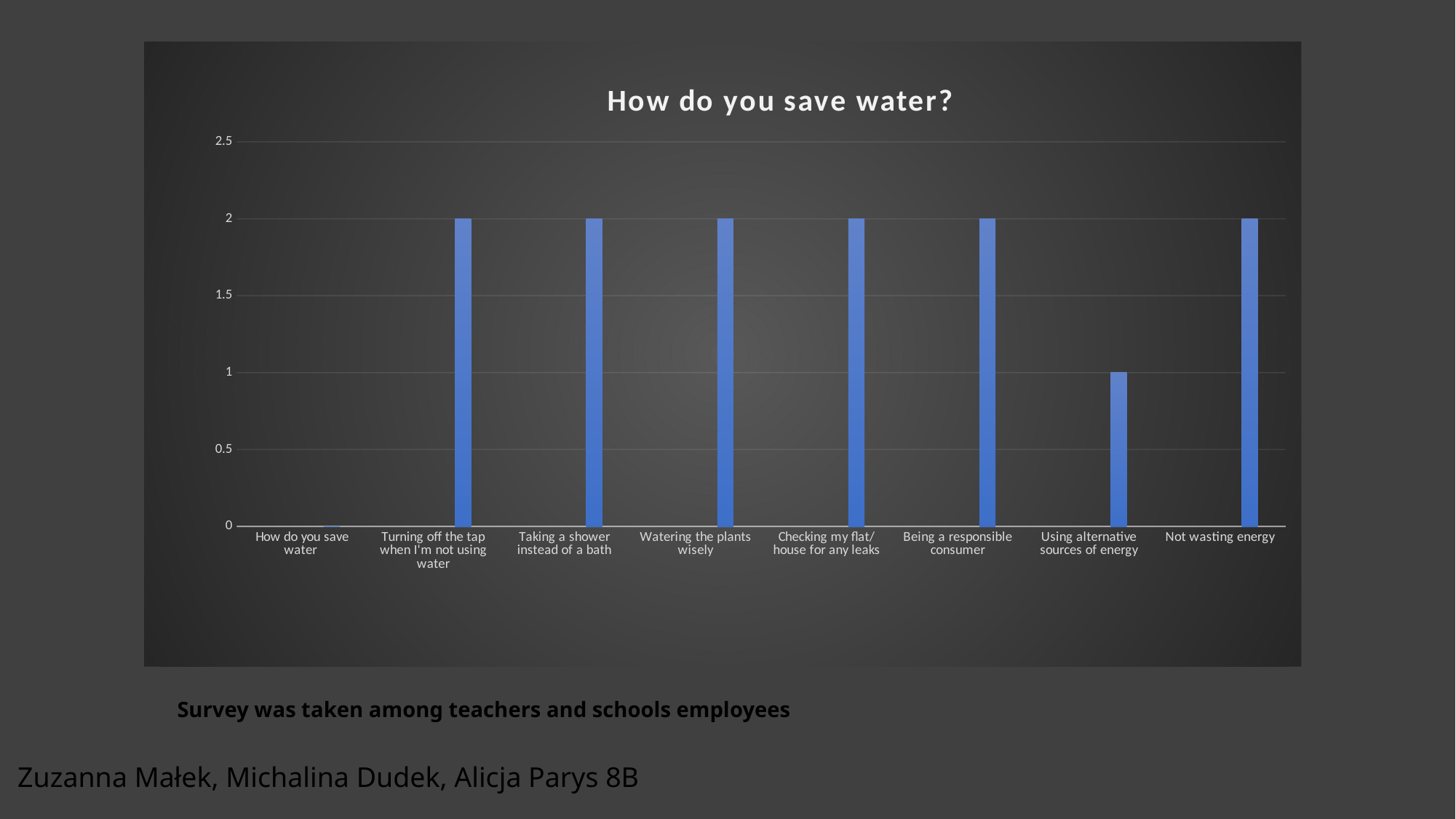
Which is larger, the value for "Being a responsible consumer" or the value for "Using alternative sources of energy"? Being a responsible consumer What is the difference between the values for "Not wasting energy" and "Using alternative sources of energy"? 1 What is the value for "Not wasting energy"? 2 What is the value for "Turning off the tap when I'm not using water"? 2 What is the title of the chart? How do you save water? What is the value for "Watering the plants wisely"? 2 What type of chart is shown on the slide? bar chart What is the value for "Using alternative sources of energy"? 1 How many categories are shown on the x axis? 8 Is the value for "Using alternative sources of energy" greater or less than 1.5? less Which category has the shortest visible bar? Using alternative sources of energy Is the value for "Checking my flat/house for any leaks" greater or less than 1.5? greater